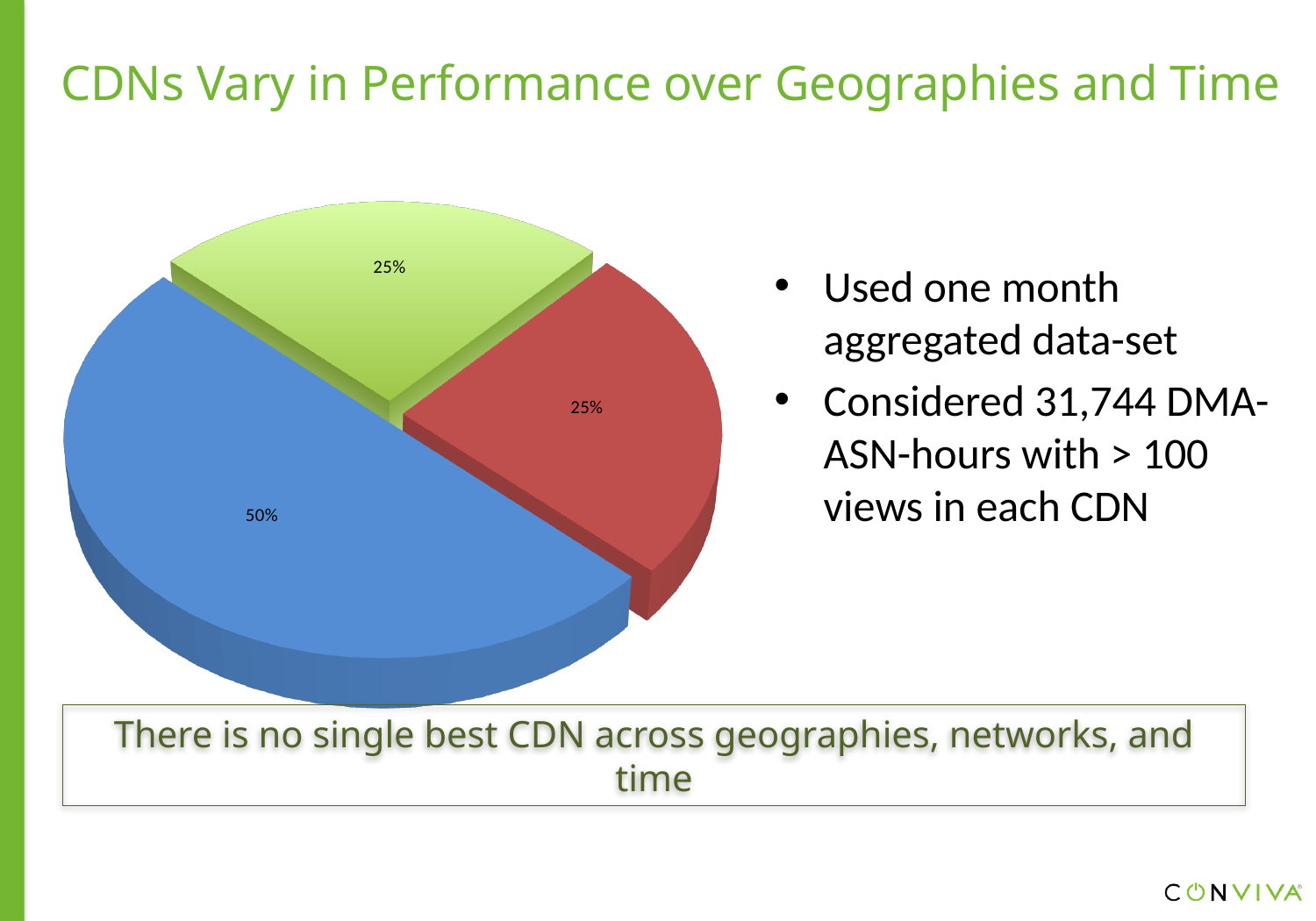
Which colour slice is the largest in the pie chart? blue By how many percentage points is the blue slice larger than the green slice? 25 What share of the pie does the blue slice represent? 50% What is the combined share of the red and green slices? 50% What share of the pie does the red slice represent? 25% What share of the pie does the green slice represent? 25% Does the pie chart include a legend? no Which is larger, the blue slice or the red slice? blue What three colours are used for the slices of the pie chart? blue, red, green What kind of chart is shown on the slide? pie chart Do the red and green slices have the same share of the pie? yes How many slices does the pie chart have? 3